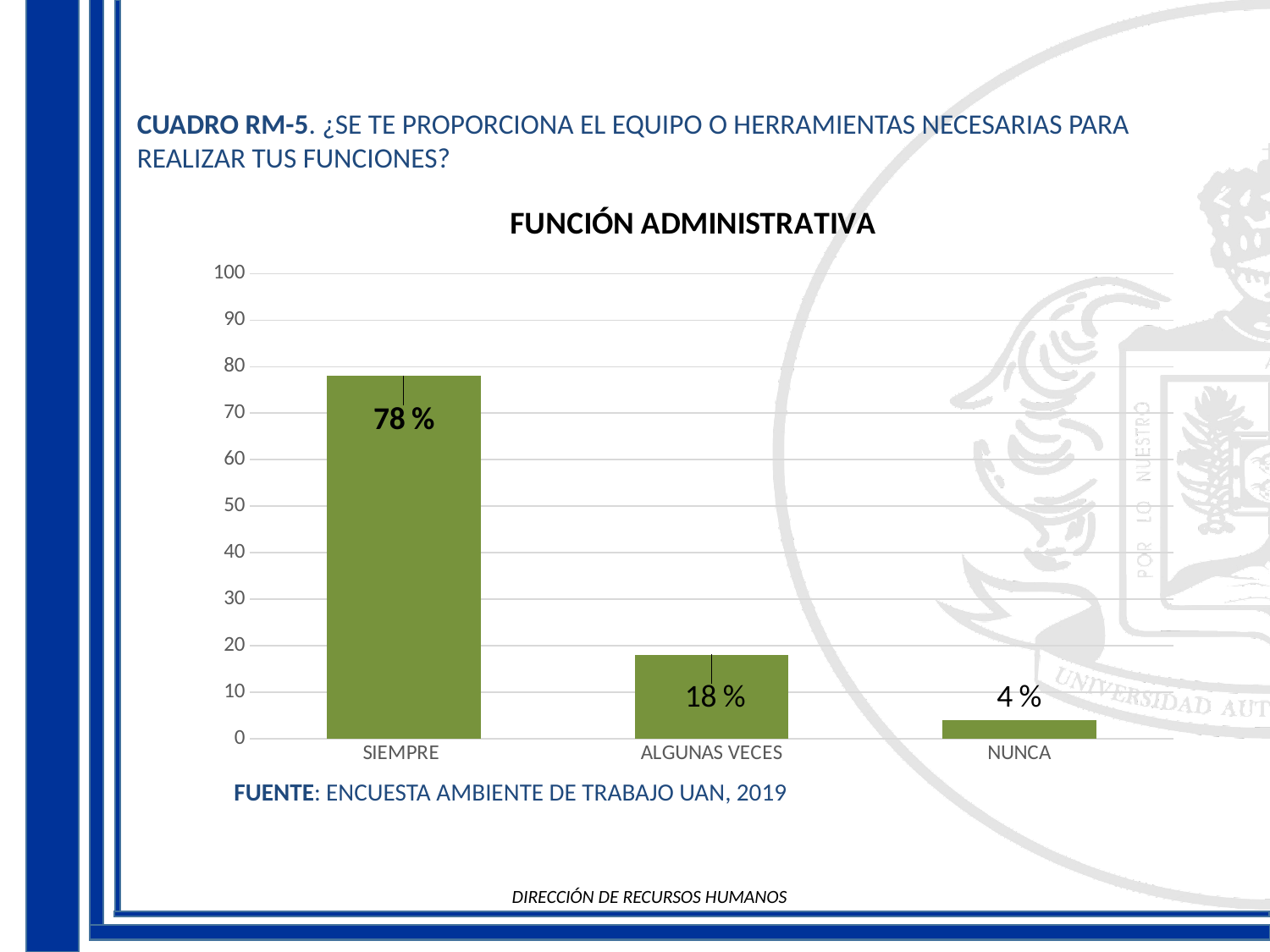
Which is larger, the value for ALGUNAS VECES or the value for NUNCA? ALGUNAS VECES What is the value for ALGUNAS VECES? 18 % What is the value for NUNCA? 4 % Is the value for SIEMPRE greater or less than 70? greater What is the difference between the values for SIEMPRE and ALGUNAS VECES? 60 % What is the value for SIEMPRE? 78 % What is the title of the chart? FUNCIÓN ADMINISTRATIVA Which category has the lowest value? NUNCA What is the difference between the values for ALGUNAS VECES and NUNCA? 14 % What kind of chart is shown on the slide? bar chart How many categories are shown on the x axis? 3 Which category has the highest value? SIEMPRE